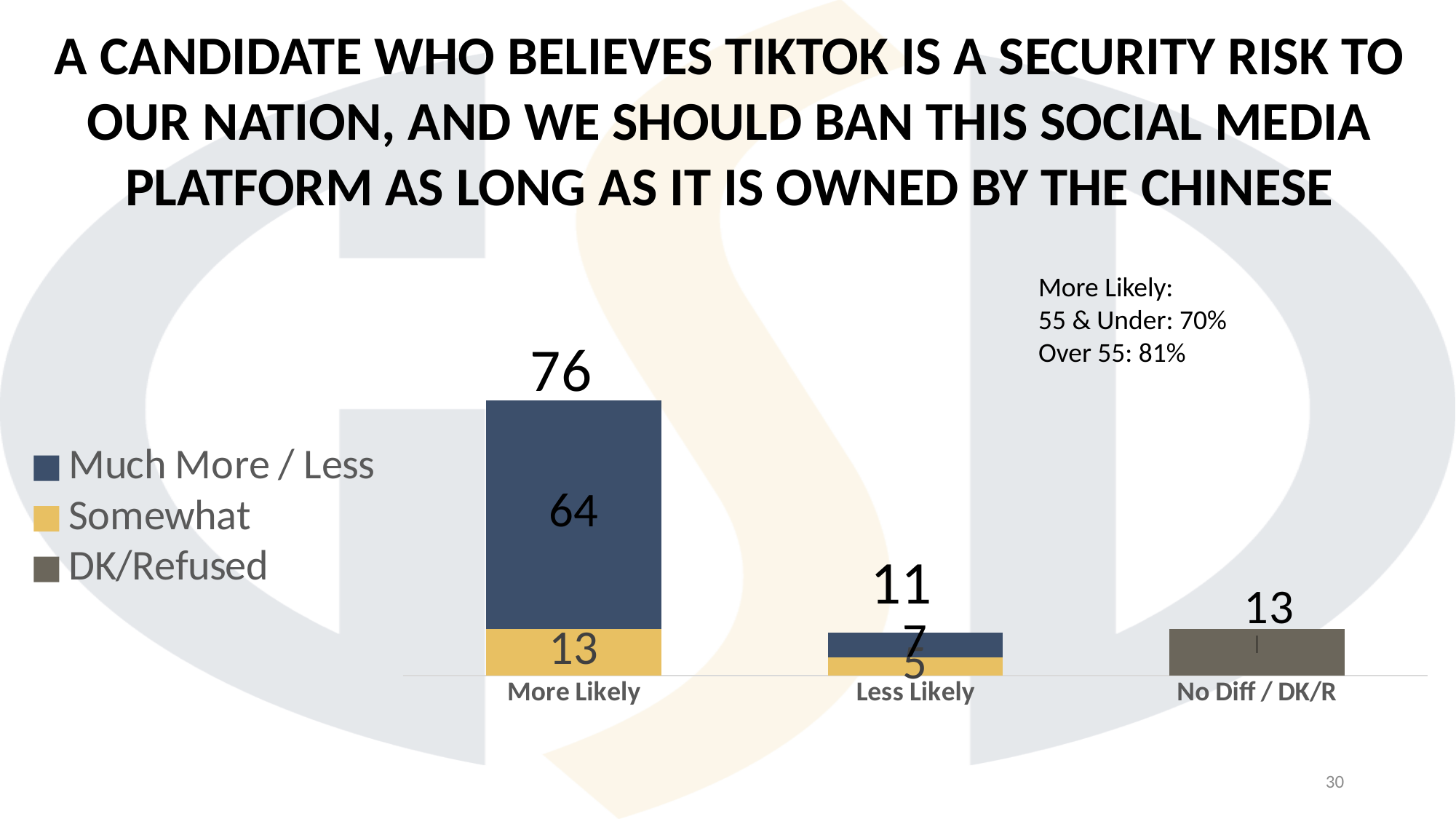
What is the Somewhat value for the More Likely bar? 13 What value is shown for the No Diff / DK/R bar? 13 What is the Somewhat value for the Less Likely bar? 5 How many series does the legend list? 3 What is the difference between the Much More / Less value and the Somewhat value in the More Likely bar? 51 Which category has the highest total? More Likely Which category has the lowest total? Less Likely What is the Much More / Less value for the Less Likely bar? 7 How many categories are shown on the x axis? 3 What is the Much More / Less value for the More Likely bar? 64 What total is printed above the Less Likely stacked bar? 11 What total is printed above the More Likely stacked bar? 76